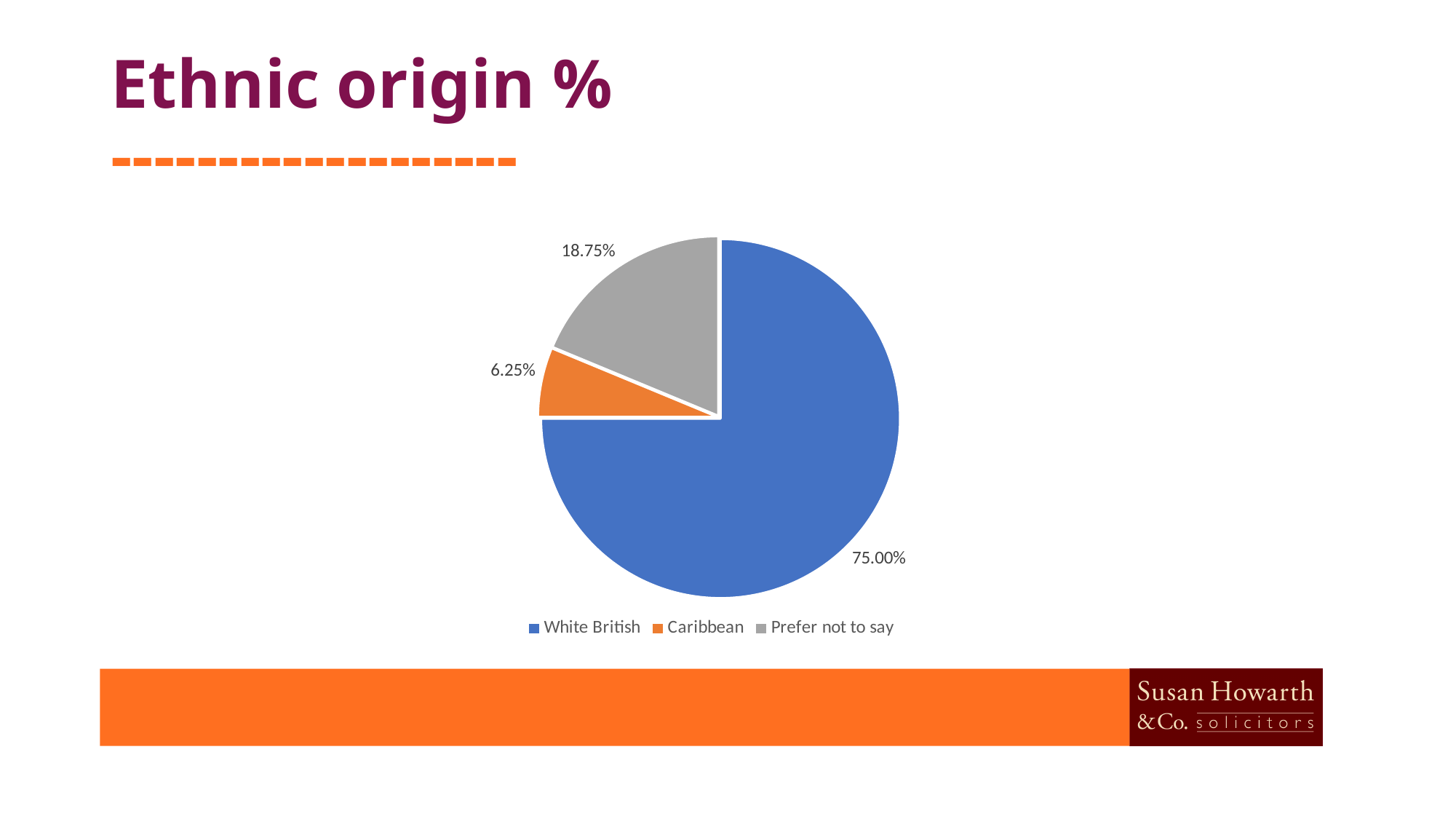
What is the title of the slide containing the chart? Ethnic origin % Which category has the largest share of the pie? White British What is the difference in percentage points between Prefer not to say and Caribbean? 12.5 What percentage of the pie is Caribbean? 6.25% What colour is the Caribbean slice in the pie chart? orange Which is larger, the Caribbean slice or the Prefer not to say slice? Prefer not to say What percentage of the pie is White British? 75.00% What percentage of the pie is Prefer not to say? 18.75% What is the difference in percentage points between White British and Prefer not to say? 56.25 What kind of chart is shown on the slide? pie chart How many slices does the pie chart have? 3 Which category has the smallest share of the pie? Caribbean